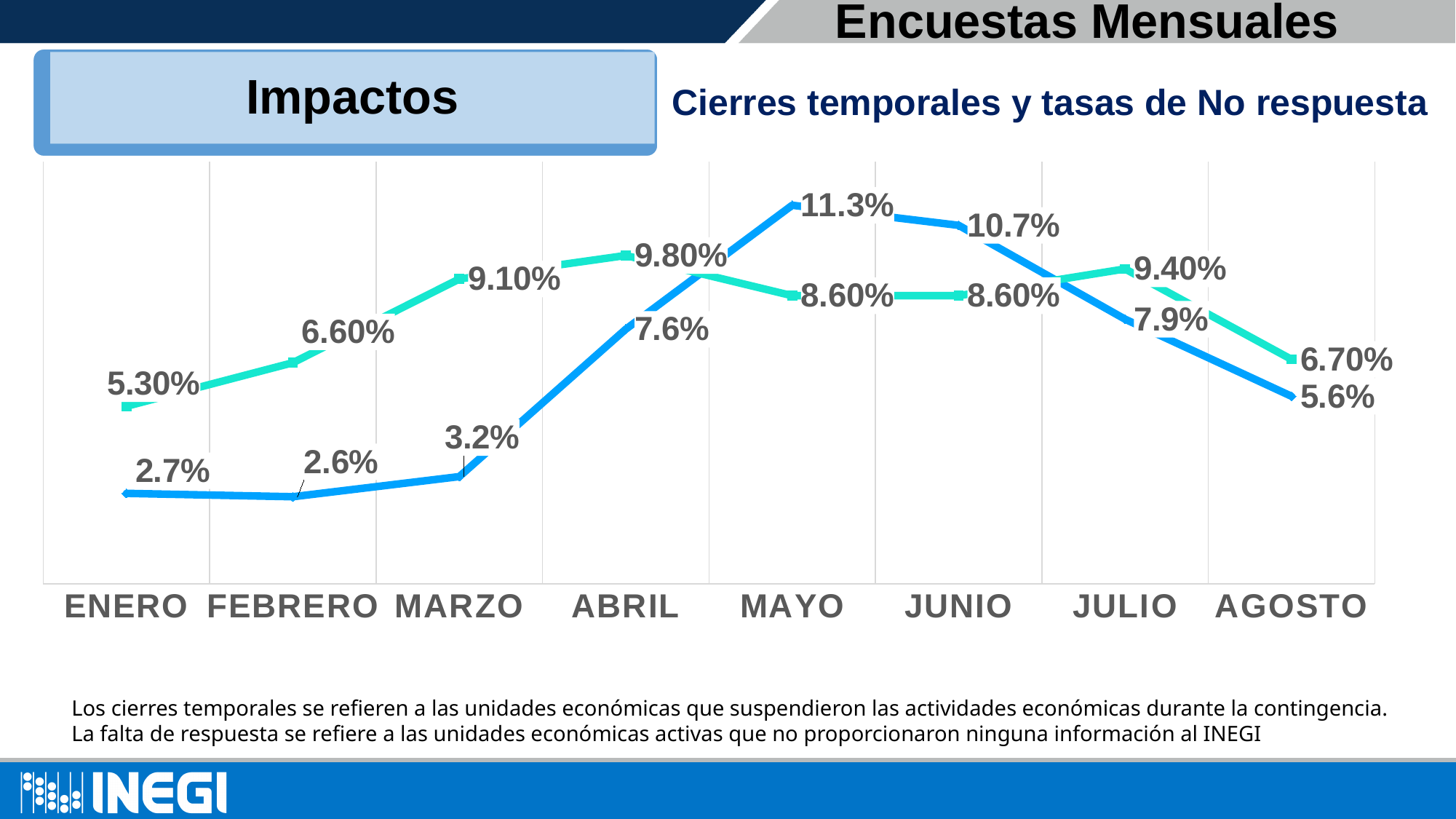
What is the value of the green line in ENERO? 5.30% What is the value of the blue line in MAYO? 11.3% What is the difference between the blue line's value in MAYO and its value in JUNIO? 0.6% What is the title of the chart? Cierres temporales y tasas de No respuesta In MARZO, which line has the larger value, the blue line or the green line? the green line What type of chart is shown on the slide? line chart In which month does the blue line have its lowest value? FEBRERO In which month does the blue line reach its highest value? MAYO What is the value of the green line in AGOSTO? 6.70% In which month does the green line reach its highest value? ABRIL What is the value of the blue line in FEBRERO? 2.6% How many months are shown on the x axis of the chart? 8